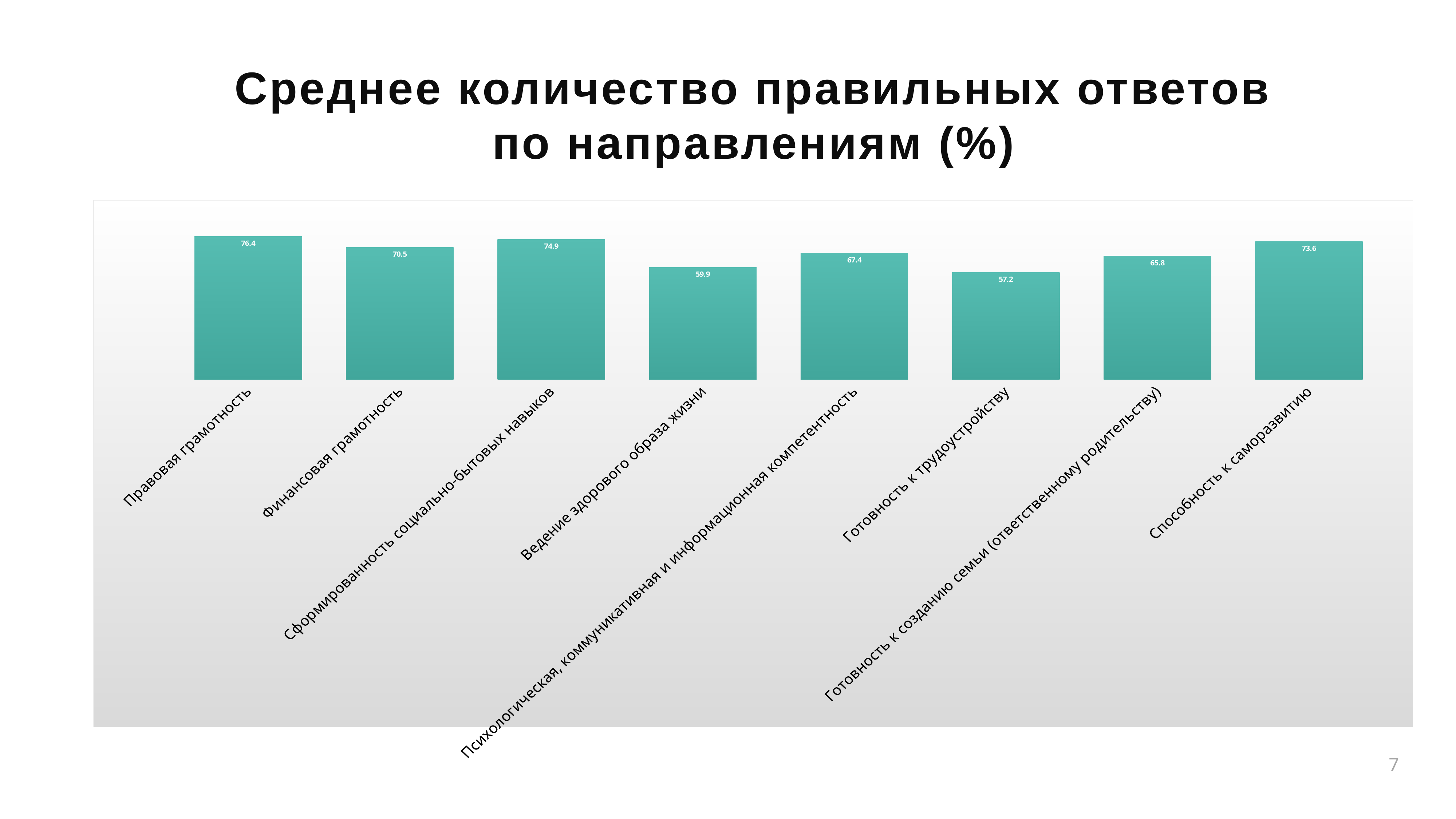
What is the difference between the values for Правовая грамотность and Готовность к трудоустройству? 19.2 How many categories are shown in the chart? 8 Which is larger: the value for Сформированность социально-бытовых навыков or the value for Психологическая, коммуникативная и информационная компетентность? Сформированность социально-бытовых навыков What kind of chart is shown on the slide? Bar chart What is the title of the slide? Среднее количество правильных ответов по направлениям (%) Which category has the lowest value? Готовность к трудоустройству What is the value for Правовая грамотность? 76.4 What is the value for Ведение здорового образа жизни? 59.9 What is the difference between the values for Финансовая грамотность and Готовность к созданию семьи (ответственному родительству)? 4.7 What is the value for Способность к саморазвитию? 73.6 Which category has the highest value? Правовая грамотность What is the value for Готовность к трудоустройству? 57.2